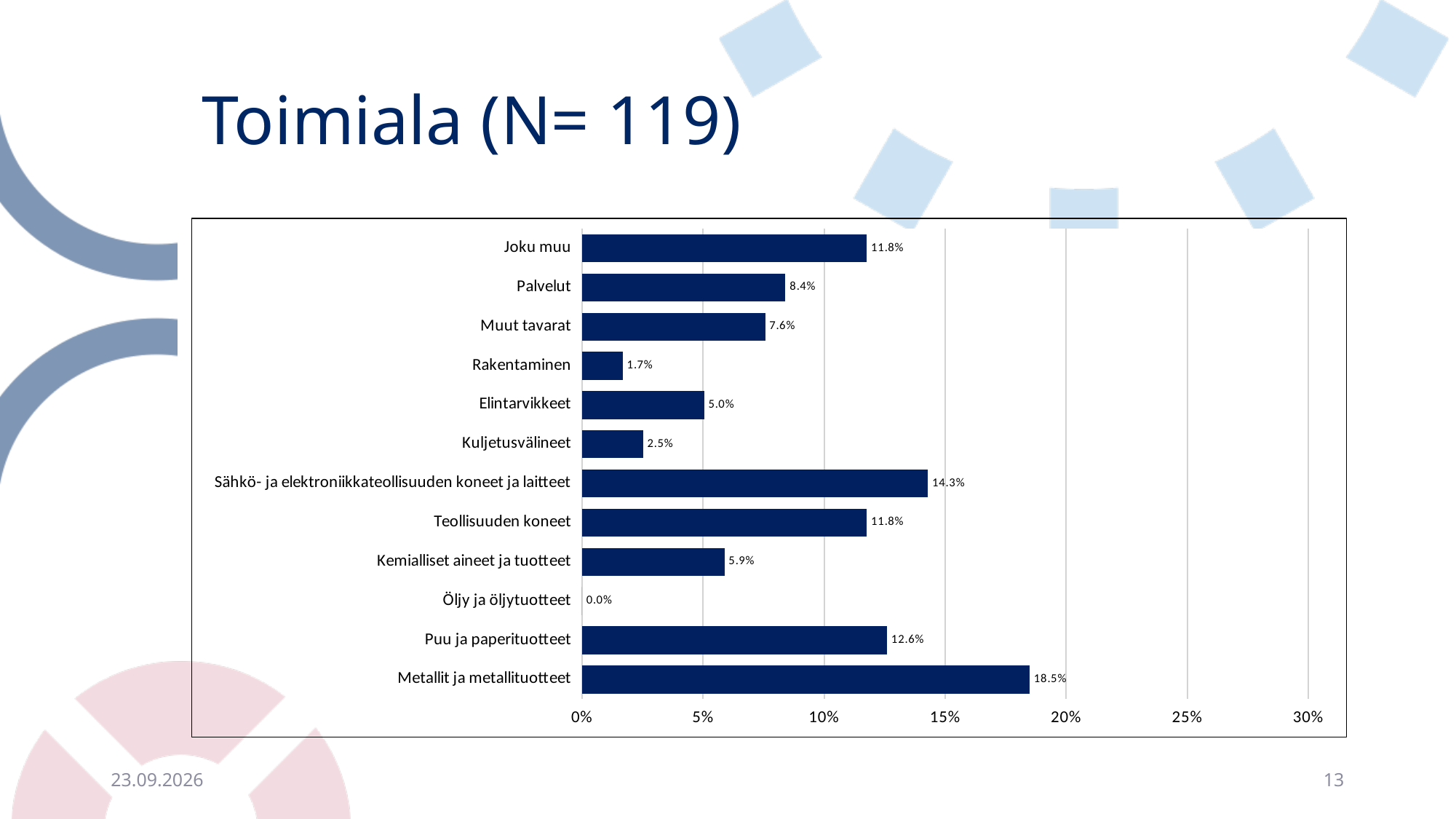
Which is larger, the value for Palvelut or the value for Muut tavarat? Palvelut What is the value for Sähkö- ja elektroniikkateollisuuden koneet ja laitteet? 14.3% What is the title of the slide containing the chart? Toimiala (N= 119) What is the value for Rakentaminen? 1.7% What is the difference between the values for Metallit ja metallituotteet and Puu ja paperituotteet? 5.9% What is the value for Metallit ja metallituotteet? 18.5% Which category has the highest value? Metallit ja metallituotteet How many categories are shown in the chart? 12 What is the highest value shown on the x axis? 30% Is the value for Teollisuuden koneet greater or less than 10%? greater Which category has the lowest value? Öljy ja öljytuotteet What kind of chart is shown on the slide? Bar chart